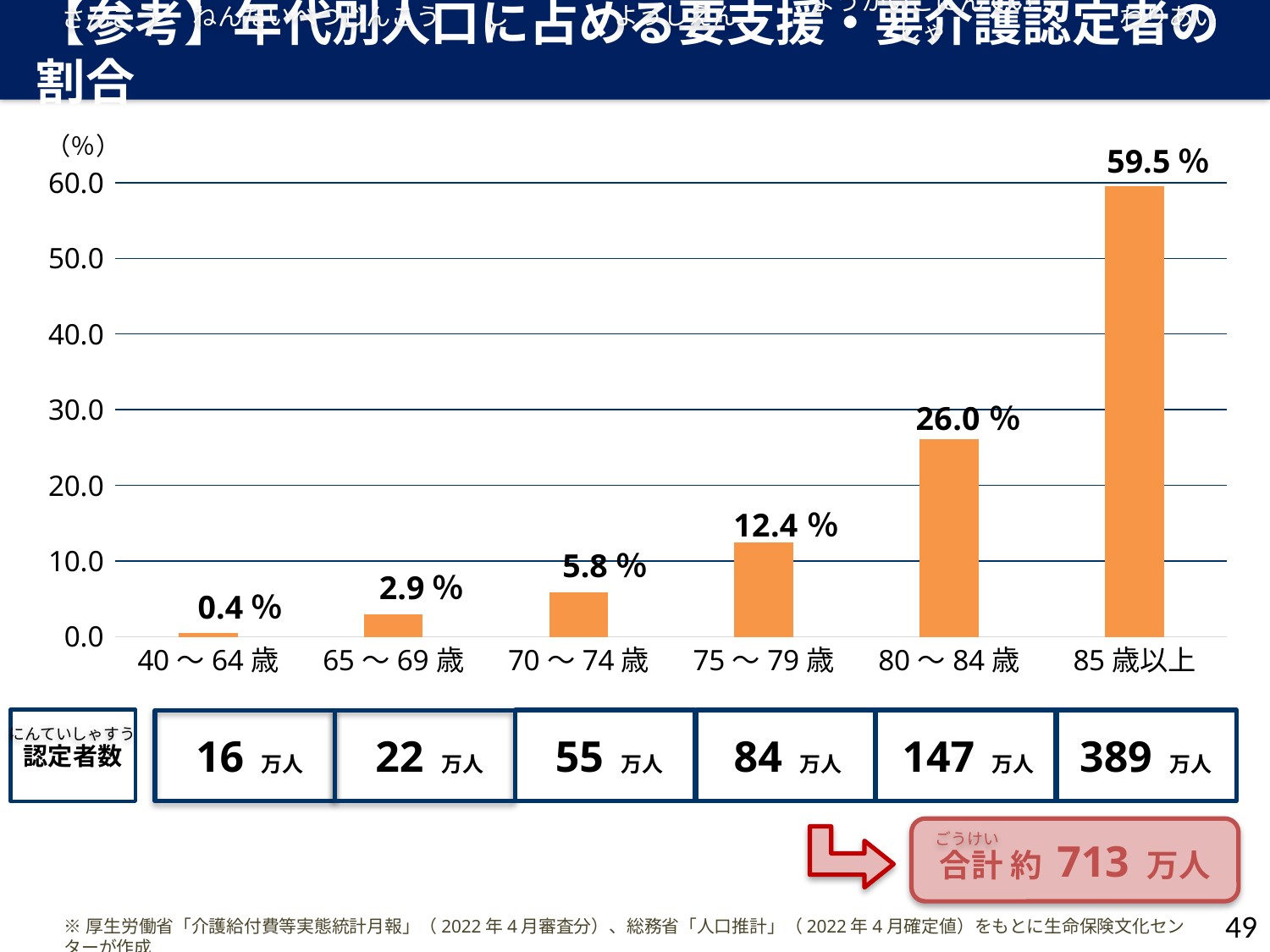
Which age group has the highest value? 85歳以上 Which age group has the lowest value? 40～64歳 What is the value for 85歳以上? 59.5 % What unit is shown at the top of the y axis? (%) Which is larger, the value for 70～74歳 or the value for 65～69歳? 70～74歳 What kind of chart is shown? bar chart Is the value for 80～84歳 greater or less than 30.0? less What is the difference between the values for 80～84歳 and 75～79歳? 13.6 % What is the value for 75～79歳? 12.4 % Do the values rise or fall as the age groups move from left to right? rise How many age groups are shown on the x axis? 6 What is the value for 40～64歳? 0.4 %